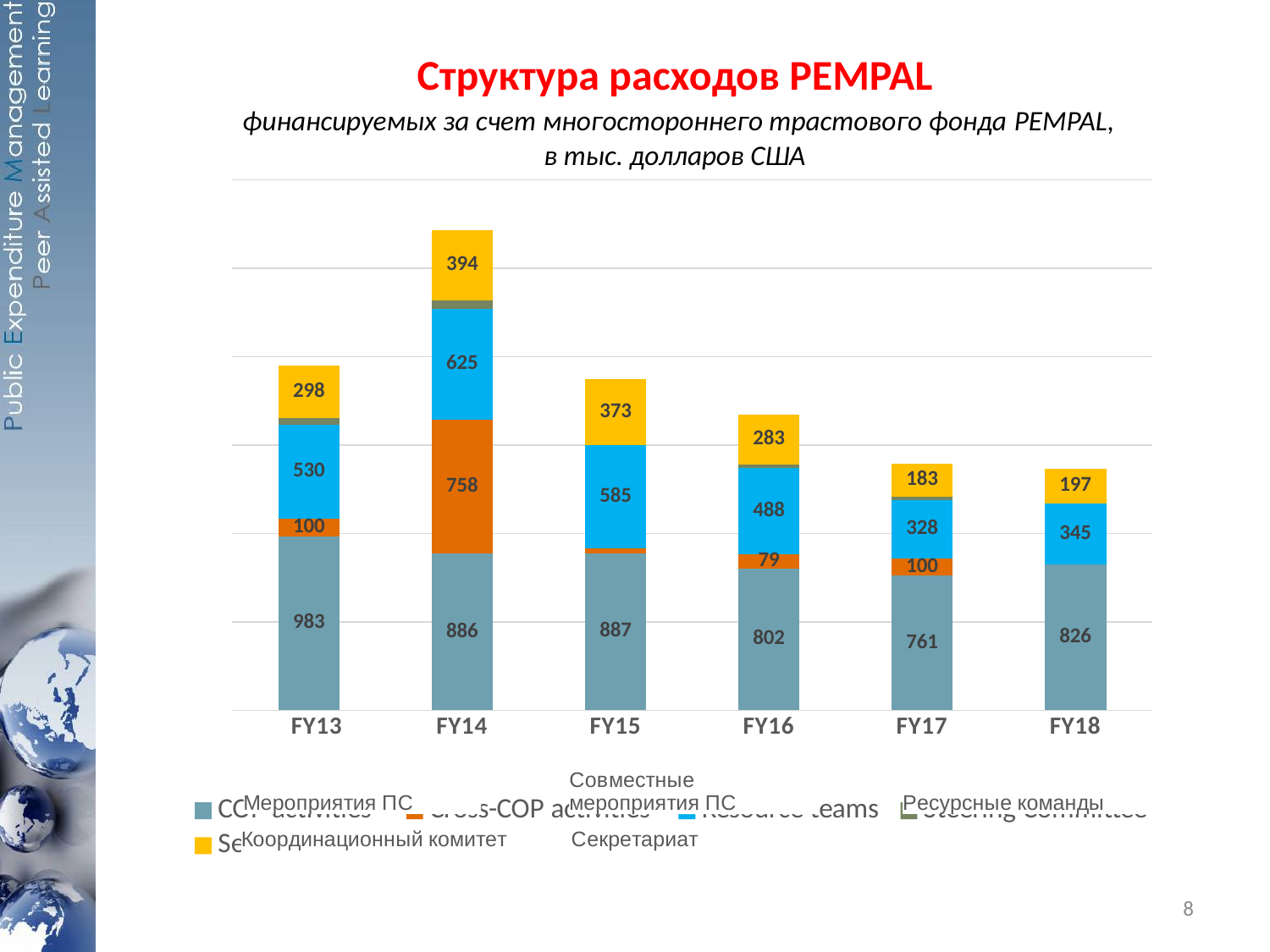
How many fiscal years are shown on the x axis? 6 What is the Secretariat (Секретариат) value for FY14? 394 Which is larger, the COP activities value for FY15 or for FY16? FY15 What is the Cross-COP activities (Совместные мероприятия ПС) value for FY16? 79 What is the difference between the Resource teams values for FY14 and FY13? 95 What is the difference between the Secretariat values for FY15 and FY16? 90 Which fiscal year has the tallest stacked bar overall? FY14 What kind of chart is shown on the slide? Stacked bar chart What is the value of COP activities (Мероприятия ПС) for FY13? 983 What is the Resource teams (Ресурсные команды) value for FY16? 488 How many series does the legend list? 5 Which fiscal year has the lowest Secretariat (Секретариат) value? FY17